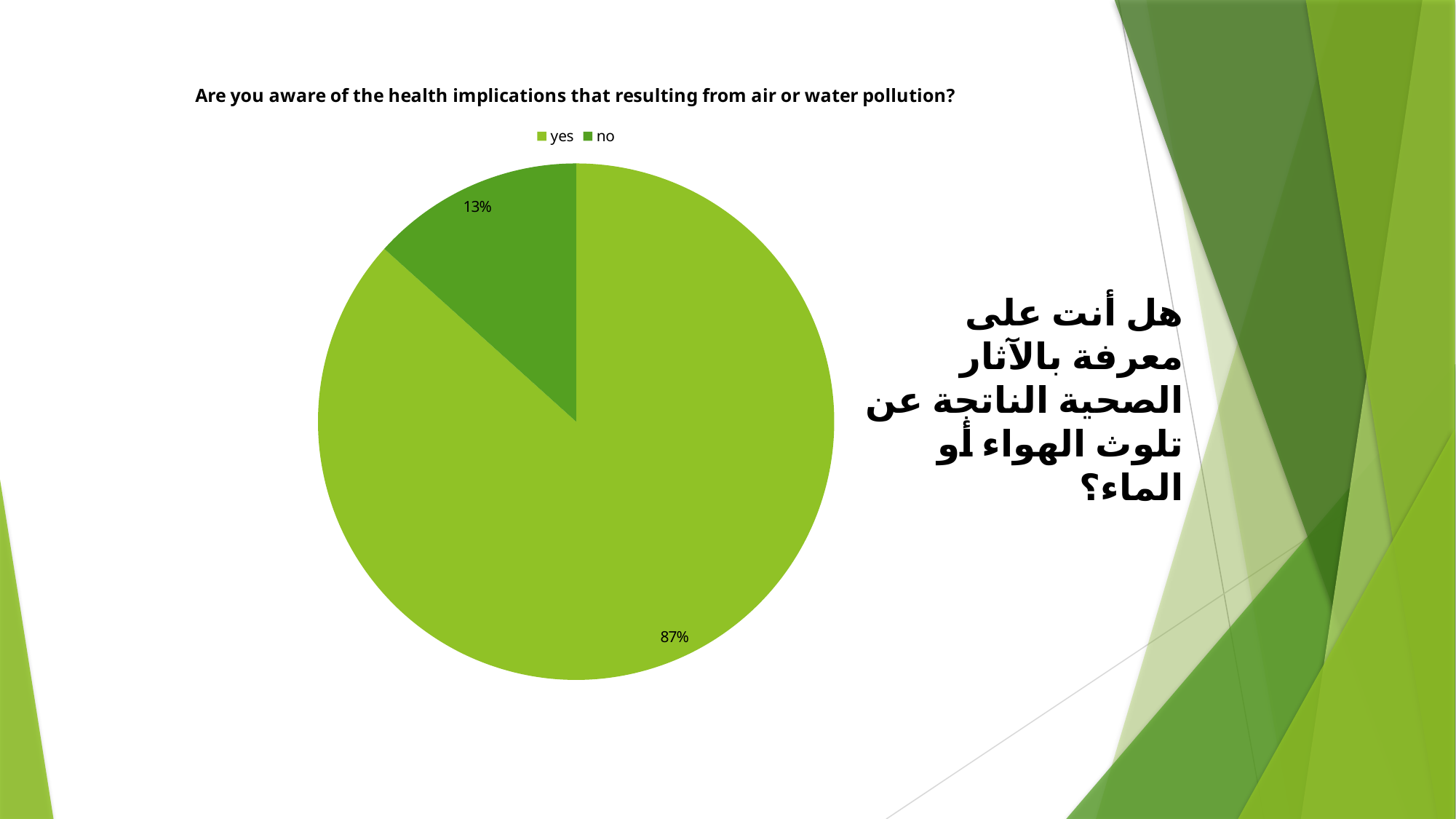
Which response has the largest share of the pie? yes Which legend entry is shown first, on the left? yes How many entries does the legend list? 2 How many slices does the pie chart have? 2 What percentage of respondents answered "yes"? 87% What is the difference in percentage points between the "yes" and "no" slices? 74 Which is larger, the "yes" slice or the "no" slice? yes What is the title of the chart? Are you aware of the health implications that resulting from air or water pollution? What kind of chart is shown on the slide? pie chart What share of the pie does the "no" slice represent? 13% What percentage of respondents answered "no"? 13% Which response has the smallest share of the pie? no